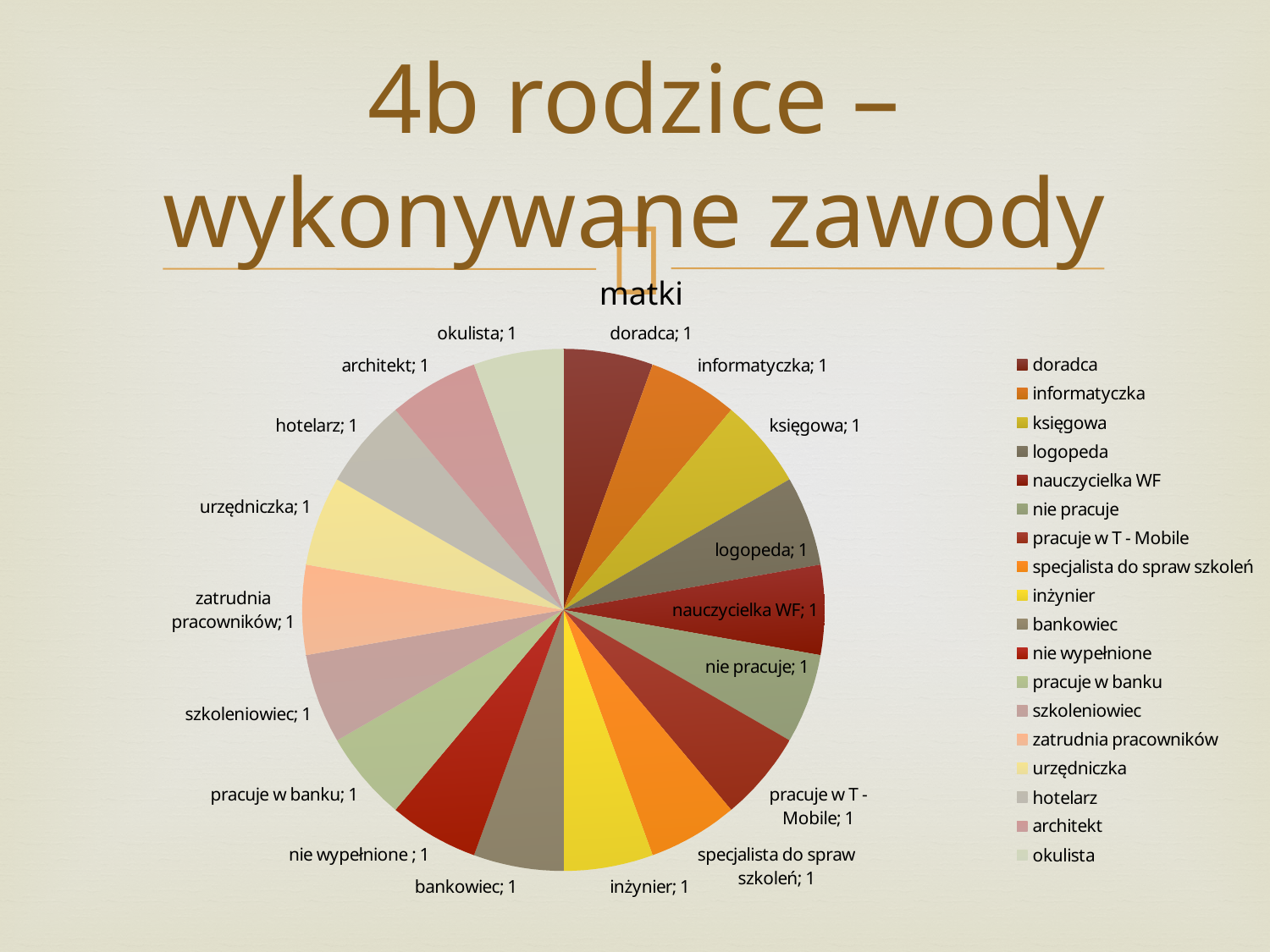
What is the value shown for the slice labelled 'pracuje w T - Mobile'? 1 Which legend entry is listed first? doradca What is the title of the chart? matki What is the value shown for the slice labelled 'doradca'? 1 What is the difference between the value for 'księgowa' and the value for 'inżynier'? 0 What is the value shown for the slice labelled 'okulista'? 1 How many slices does the pie chart have? 18 How many entries does the legend list? 18 Is the value for 'architekt' larger than, smaller than, or equal to the value for 'hotelarz'? equal What is the total of all the values shown on the pie chart? 18 What is the value shown for the slice labelled 'nauczycielka WF'? 1 What kind of chart is shown on the slide? pie chart